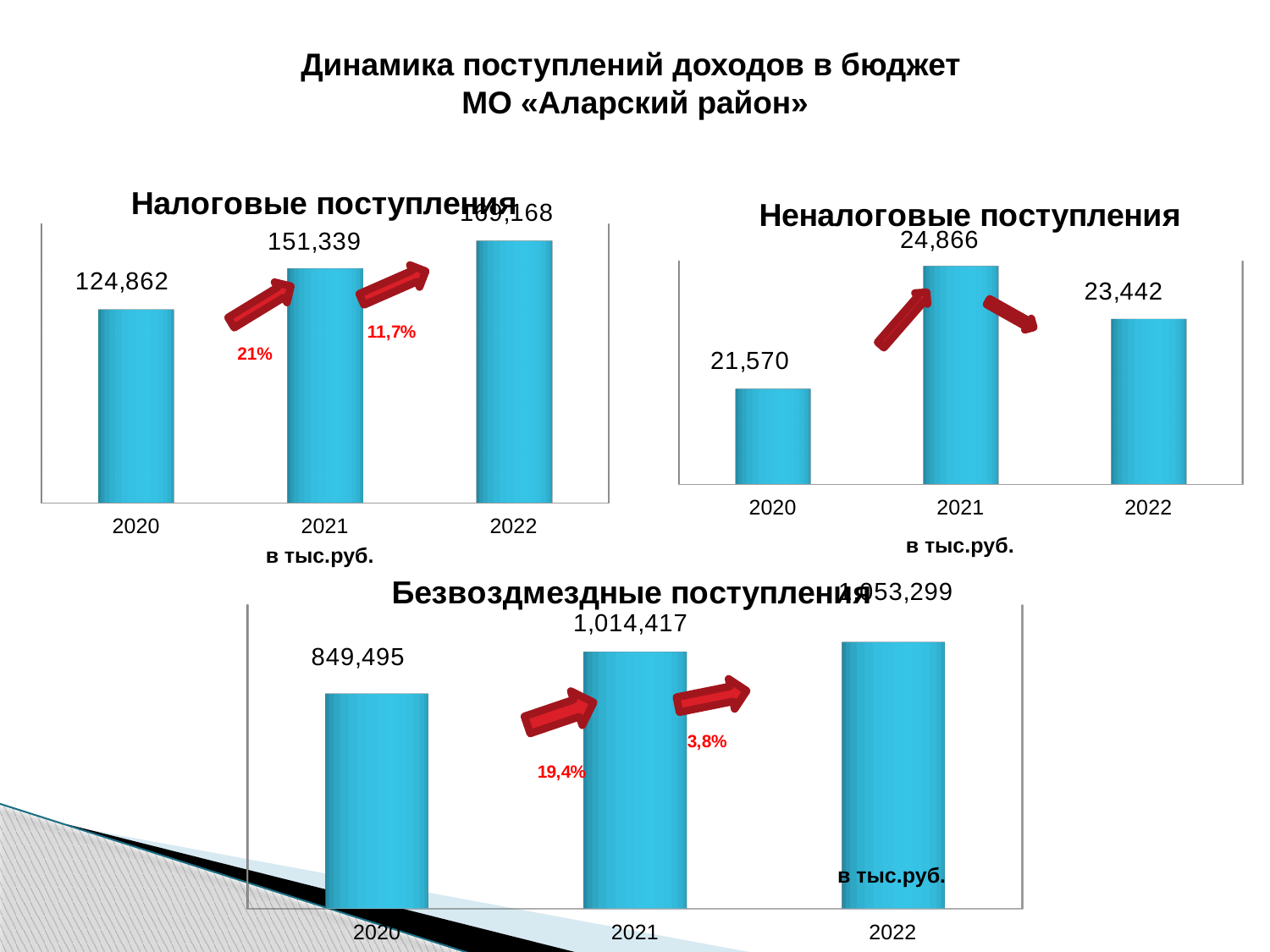
In the 'Налоговые поступления' chart, do the values rise or fall from 2020 to 2022? rise In the 'Налоговые поступления' chart, what is the difference between the 2021 and 2020 values? 26,477 In the 'Неналоговые поступления' chart, which is larger, the value for 2020 or for 2022? 2022 In the 'Неналоговые поступления' chart, what is the difference between the 2021 and 2022 values? 1,424 In the 'Налоговые поступления' chart, what is the value for 2021? 151,339 In the 'Неналоговые поступления' chart, which year has the highest value? 2021 In the 'Неналоговые поступления' chart, which year has the lowest value? 2020 In the 'Налоговые поступления' chart, what is the value for 2020? 124,862 What type of chart is the 'Безвоздмездные поступления' chart? bar chart In the 'Безвоздмездные поступления' chart, what is the value for 2021? 1,014,417 In the 'Неналоговые поступления' chart, what is the value for 2021? 24,866 In the 'Безвоздмездные поступления' chart, what is the value for 2020? 849,495